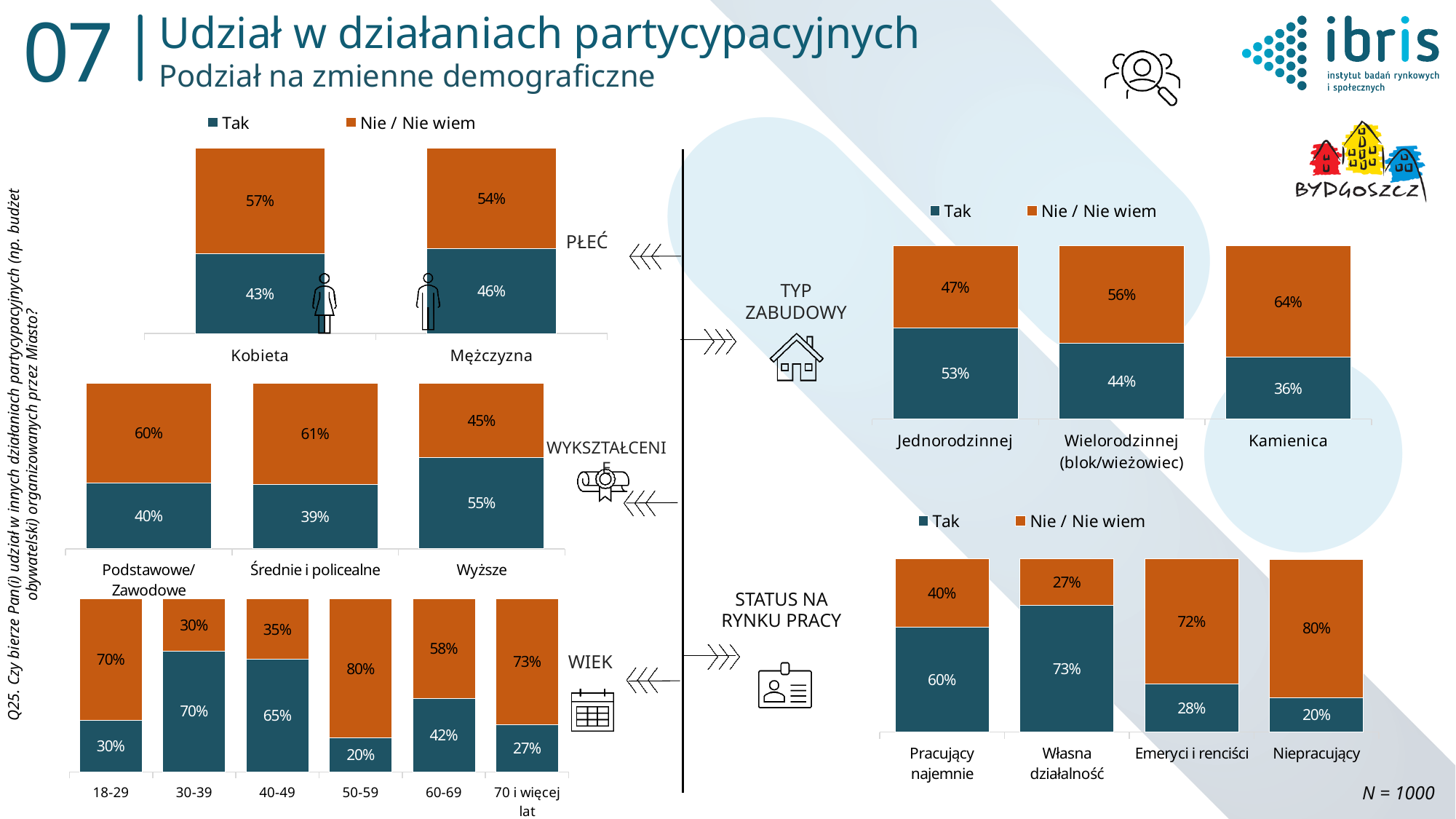
In the WIEK chart, what is the difference between the 'Tak' values for 30-39 and 18-29? 40% In the STATUS NA RYNKU PRACY chart, is the 'Tak' value for Emeryci i renciści larger or smaller than the 'Tak' value for Niepracujący? larger In the PŁEĆ chart, what is the 'Tak' value for Kobieta? 43% In the PŁEĆ chart, what is the 'Nie / Nie wiem' value for Mężczyzna? 54% In the WIEK chart, how many age categories are shown? 6 In the STATUS NA RYNKU PRACY chart, which category has the highest 'Tak' value? Własna działalność In the WYKSZTAŁCENIE chart, which education category has the highest 'Tak' value? Wyższe In the TYP ZABUDOWY chart, which housing type has the highest 'Nie / Nie wiem' value? Kamienica In the WYKSZTAŁCENIE chart, what is the 'Nie / Nie wiem' value for Średnie i policealne? 61% In the TYP ZABUDOWY chart, what is the 'Tak' value for Kamienica? 36% In the WIEK chart, which age group has the lowest 'Tak' value? 50-59 How many series does the legend of the STATUS NA RYNKU PRACY chart list? 2